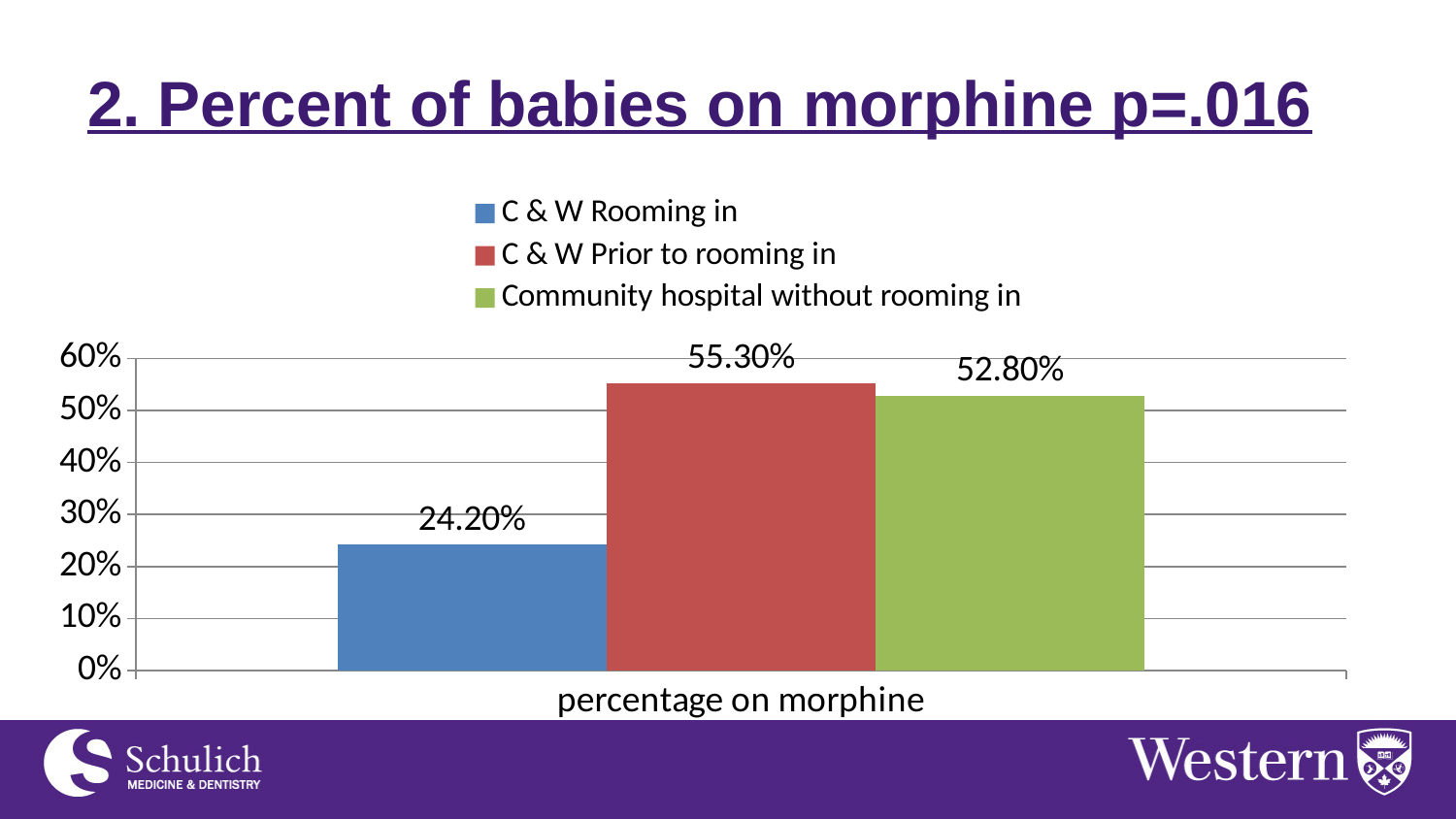
What is the percentage on morphine for C & W Rooming in? 24.20% What is the difference between the percentage on morphine for C & W Prior to rooming in and C & W Rooming in? 31.10% What is the percentage on morphine for Community hospital without rooming in? 52.80% What kind of chart is shown on the slide? bar chart What is the difference between the percentage on morphine for C & W Prior to rooming in and Community hospital without rooming in? 2.50% How many series does the legend list? 3 Is the value for C & W Rooming in greater or less than 30%? less Which series has the highest percentage on morphine? C & W Prior to rooming in What is the percentage on morphine for C & W Prior to rooming in? 55.30% Which series has the lowest percentage on morphine? C & W Rooming in Which is larger: the percentage on morphine for C & W Rooming in or for Community hospital without rooming in? Community hospital without rooming in What is the title of the slide's chart? 2. Percent of babies on morphine p=.016